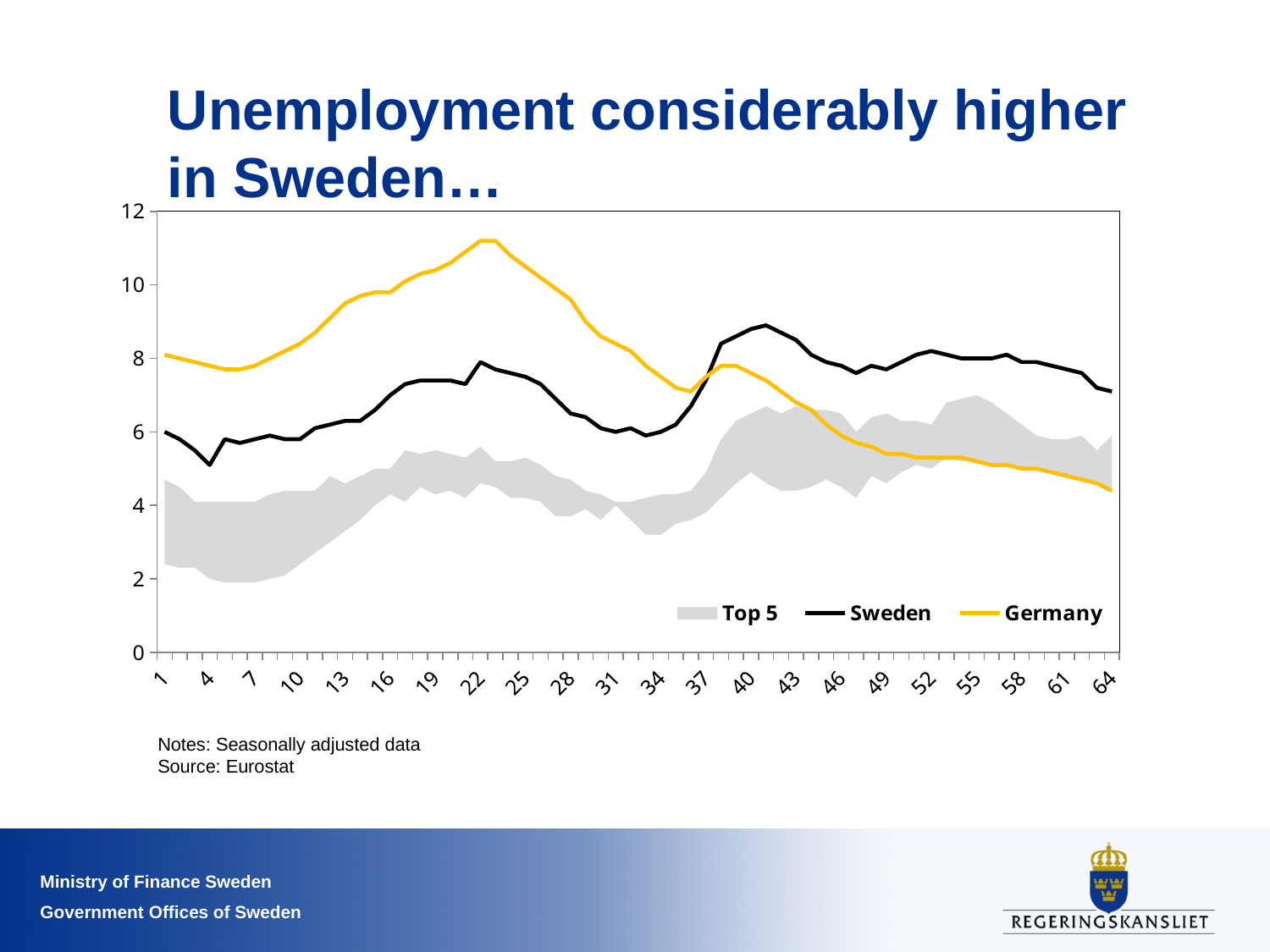
Is the value for Sweden at point 4 greater or less than 6? less Which series reaches the highest value anywhere on the chart? Germany At point 22, which series has the larger value, Sweden or Germany? Germany At point 64, which series has the larger value, Sweden or Germany? Sweden What kind of chart is shown on the slide? Combination area and line chart (a shaded band plus two lines) How many series does the legend list? 3 Is the value for Germany at point 22 greater or less than 10? greater Is the value for Sweden at point 40 greater or less than 8? greater What is the title of the chart on the slide? Unemployment considerably higher in Sweden… Does the Germany line rise or fall between point 40 and point 64? Fall What are the three series named in the legend? Top 5, Sweden, Germany